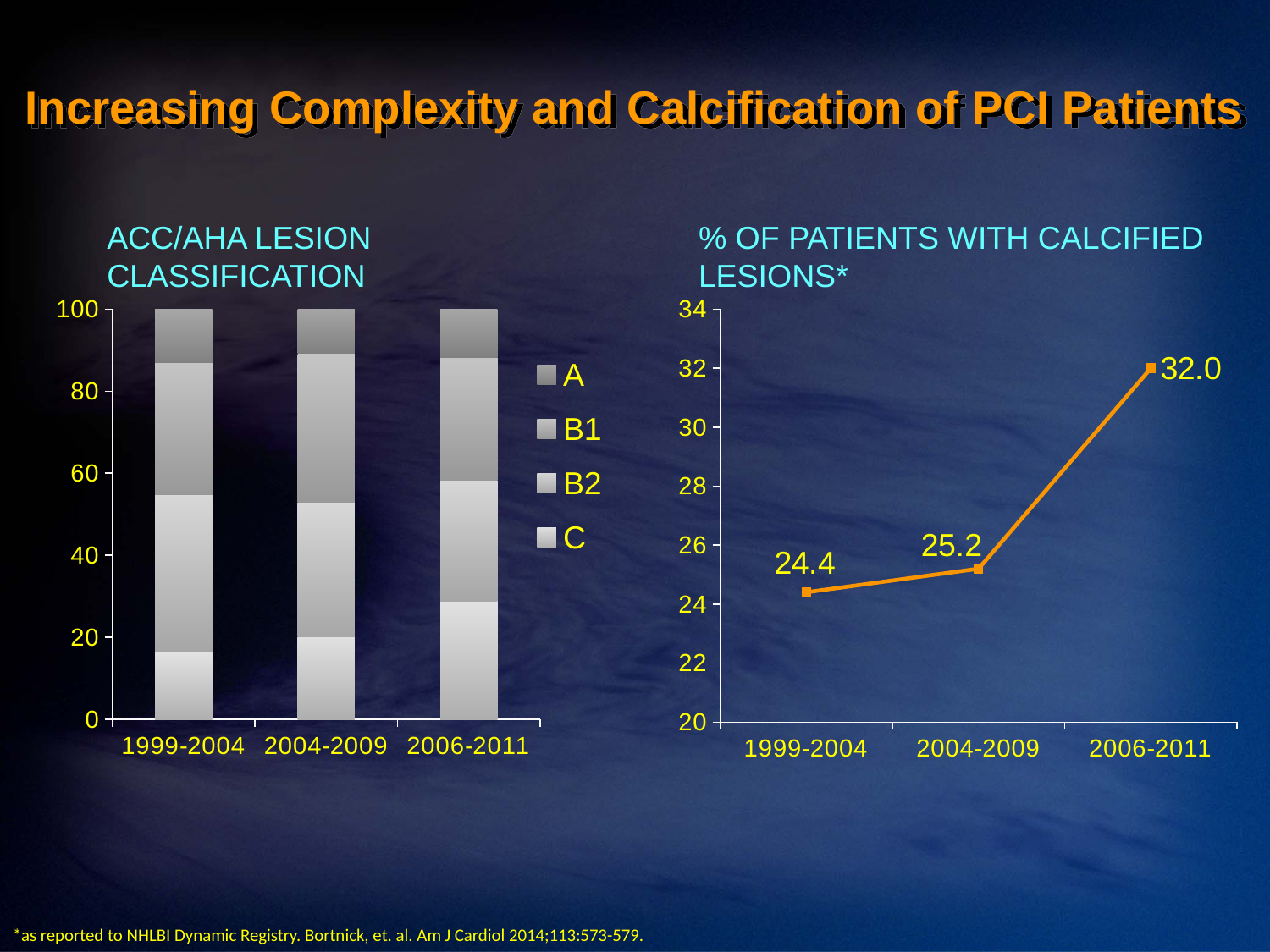
How many series does the legend of the 'ACC/AHA LESION CLASSIFICATION' chart list? 4 What kind of chart is the 'ACC/AHA LESION CLASSIFICATION' chart? stacked bar chart In the '% OF PATIENTS WITH CALCIFIED LESIONS*' chart, what is the difference between the 2006-2011 value and the 1999-2004 value? 7.6 In the '% OF PATIENTS WITH CALCIFIED LESIONS*' chart, which period has the highest value? 2006-2011 In the '% OF PATIENTS WITH CALCIFIED LESIONS*' chart, what is the value for 2006-2011? 32.0 In the '% OF PATIENTS WITH CALCIFIED LESIONS*' chart, which period has the lowest value? 1999-2004 How many time periods are shown on the x axis of the 'ACC/AHA LESION CLASSIFICATION' chart? 3 What are the legend entries in the 'ACC/AHA LESION CLASSIFICATION' chart? A, B1, B2, C In the '% OF PATIENTS WITH CALCIFIED LESIONS*' chart, what is the value for 1999-2004? 24.4 What kind of chart is the '% OF PATIENTS WITH CALCIFIED LESIONS*' chart? line chart In the '% OF PATIENTS WITH CALCIFIED LESIONS*' chart, what is the value for 2004-2009? 25.2 In the '% OF PATIENTS WITH CALCIFIED LESIONS*' chart, do the values rise or fall from 1999-2004 to 2006-2011? rise